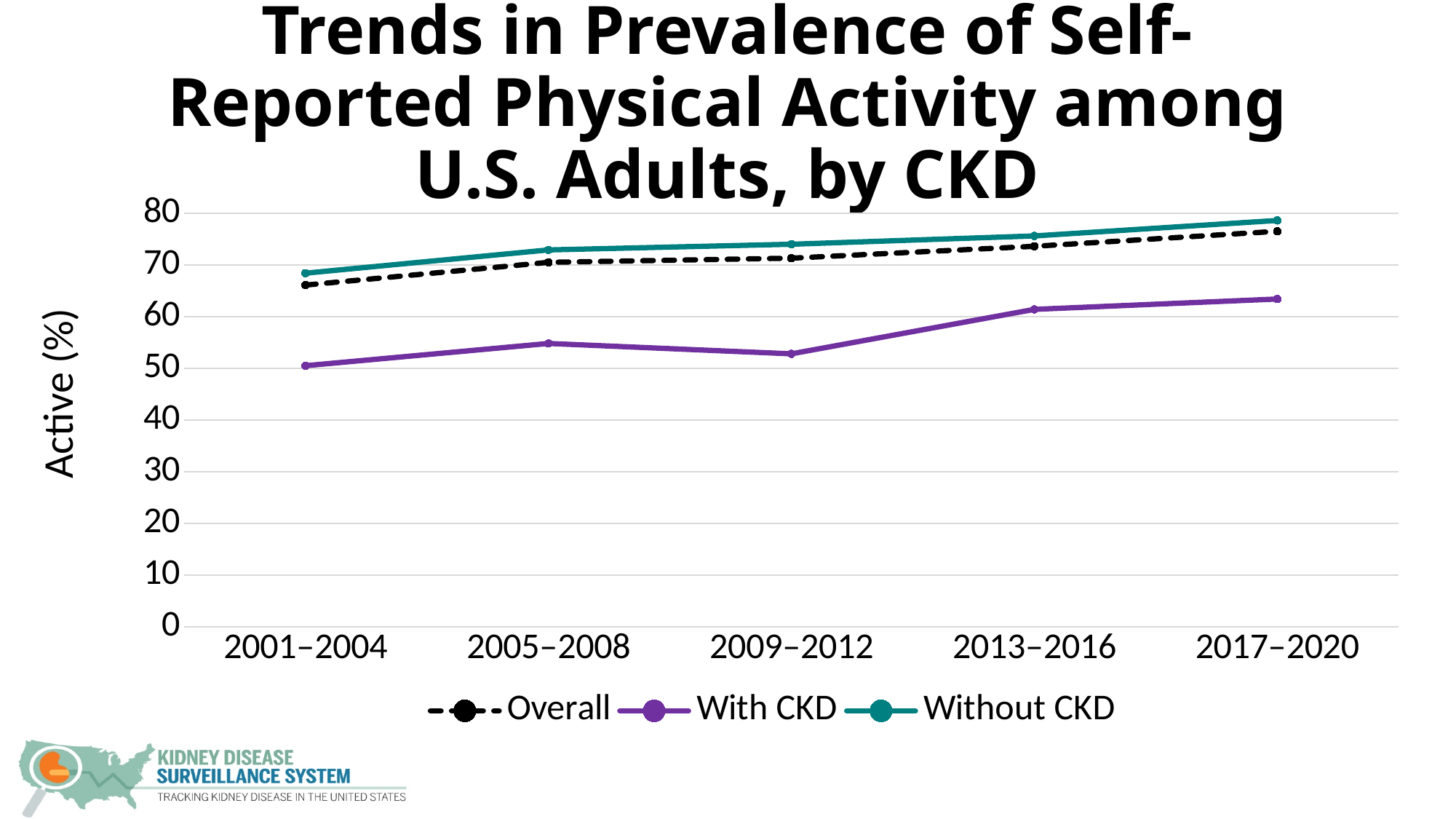
Is the value for Overall in 2001–2004 greater or less than 70? less Is the value for With CKD in 2001–2004 greater or less than 60? less How many time periods are shown on the x axis? 5 Is the value for Without CKD in 2017–2020 greater or less than 70? greater What kind of chart is shown on the slide? Line chart For the With CKD series, which is larger: the value in 2005–2008 or the value in 2009–2012? 2005–2008 Which series has the lowest value in 2001–2004? With CKD How many series does the legend list? 3 What colour is the With CKD line? Purple Which series has the highest value in 2017–2020? Without CKD Does the Without CKD series rise or fall from 2001–2004 to 2017–2020? Rises